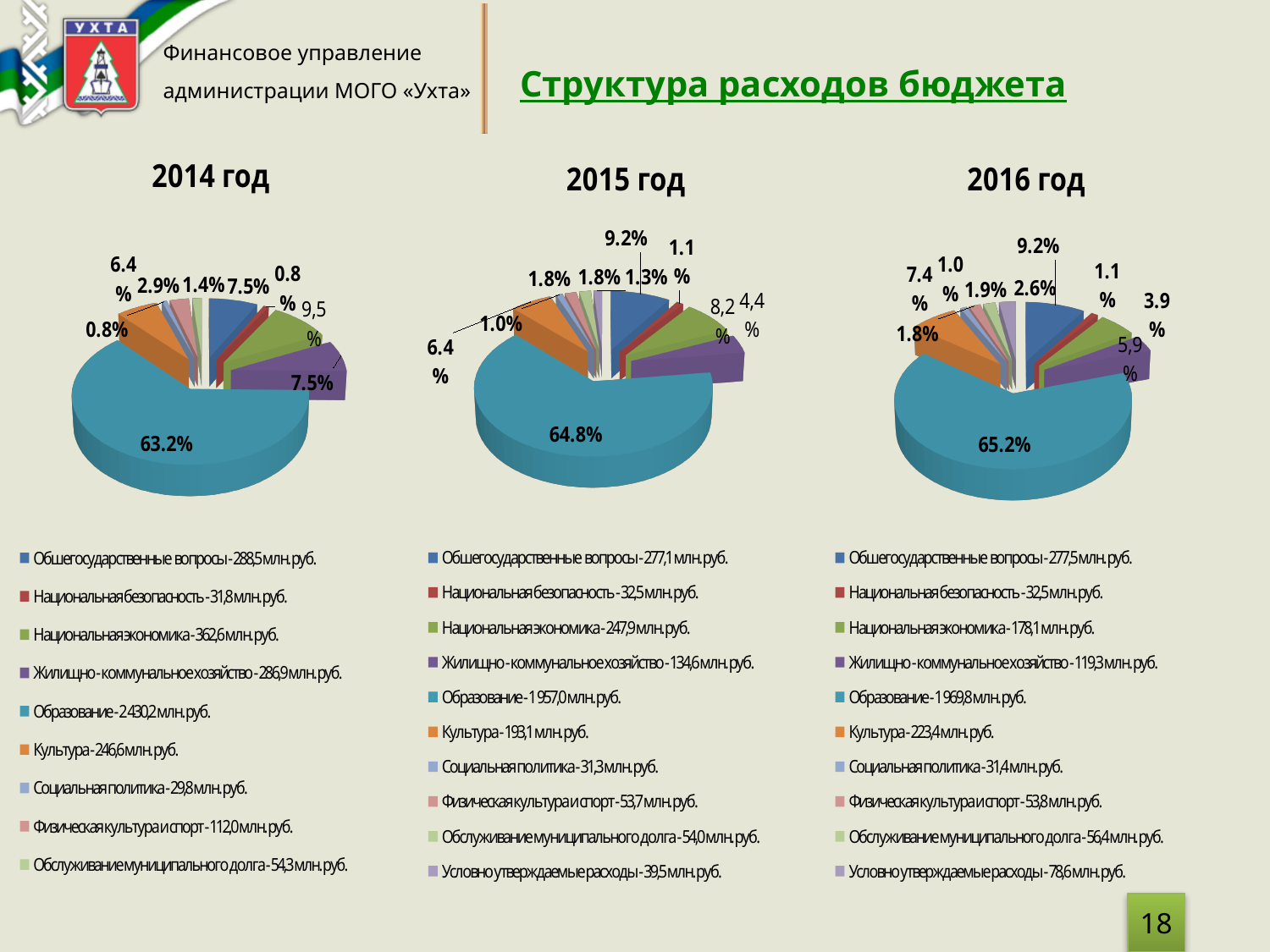
Is the share of Образование larger in the 2015 год chart or the 2016 год chart? 2016 год According to the legend of the 2014 год chart, what amount is given for Образование? 2430,2 млн.руб. In the 2016 год pie chart, what share is shown for Образование? 65.2% How many categories does the legend of the 2016 год chart list? 10 Does the share of Образование rise or fall from the 2014 год chart to the 2016 год chart? Rises In the 2014 год pie chart, which category has the largest share? Образование How many categories does the legend of the 2014 год chart list? 9 In the 2015 год pie chart, what share is shown for Образование? 64.8% By how many percentage points does the share of Образование in the 2016 год chart exceed that in the 2014 год chart? 2.0 What kind of chart is used for the 2015 год data? Pie chart In the 2014 год pie chart, what share is shown for Образование? 63.2% What is the title of the slide containing the three pie charts? Структура расходов бюджета